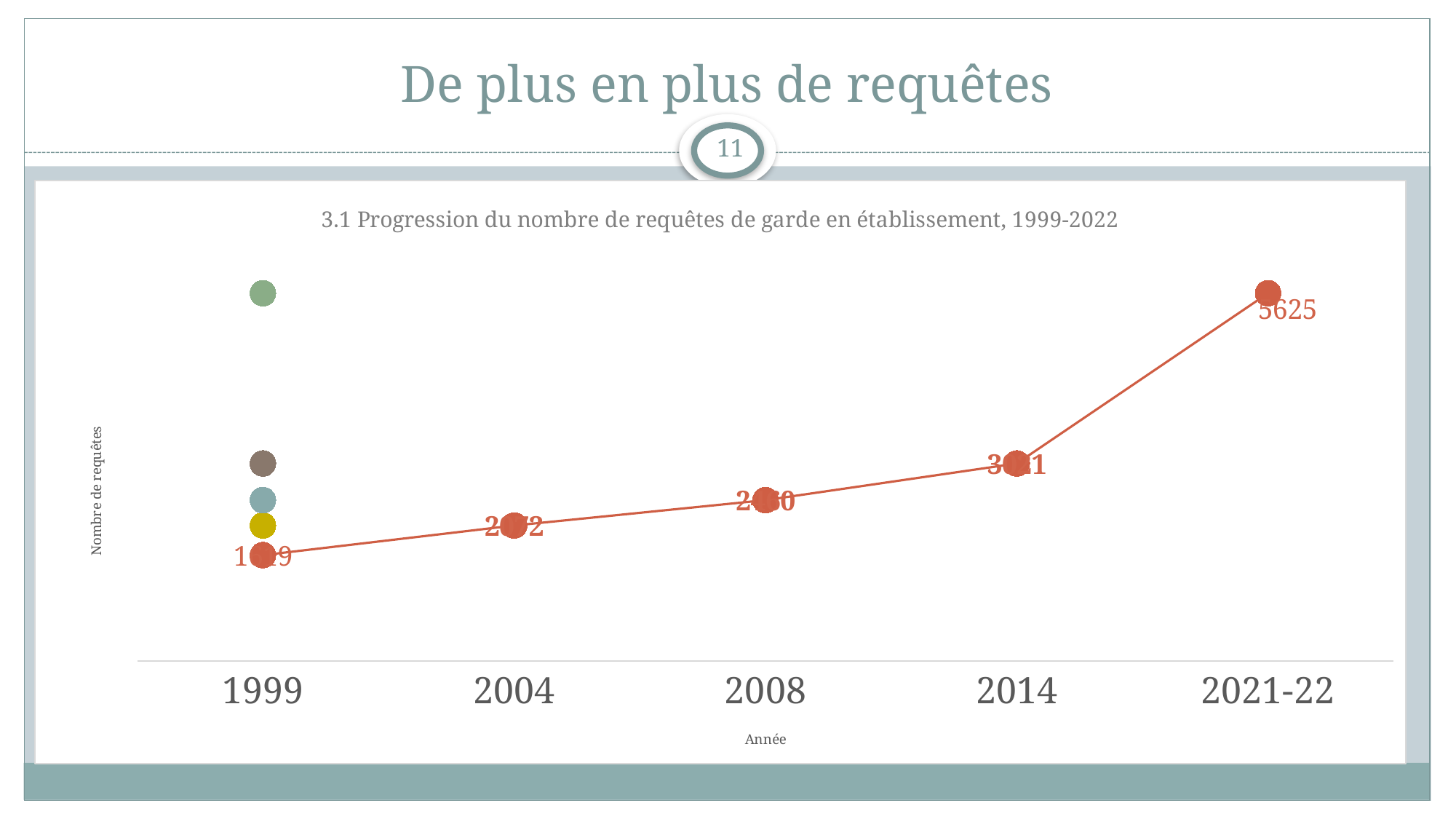
What kind of chart is shown on the slide? line chart Which has the larger value, 1999 or 2008? 2008 What is the number of requests (nombre de requêtes) for 2021-22? 5625 Which has the larger value, 2014 or 2021-22? 2021-22 What is the title of the chart? 3.1 Progression du nombre de requêtes de garde en établissement, 1999-2022 How many data points are plotted on the line? 5 What is the label of the x axis? Année Do the values rise or fall from 1999 to 2021-22? rise Which year has the highest number of requests? 2021-22 Which year has the lowest number of requests? 1999